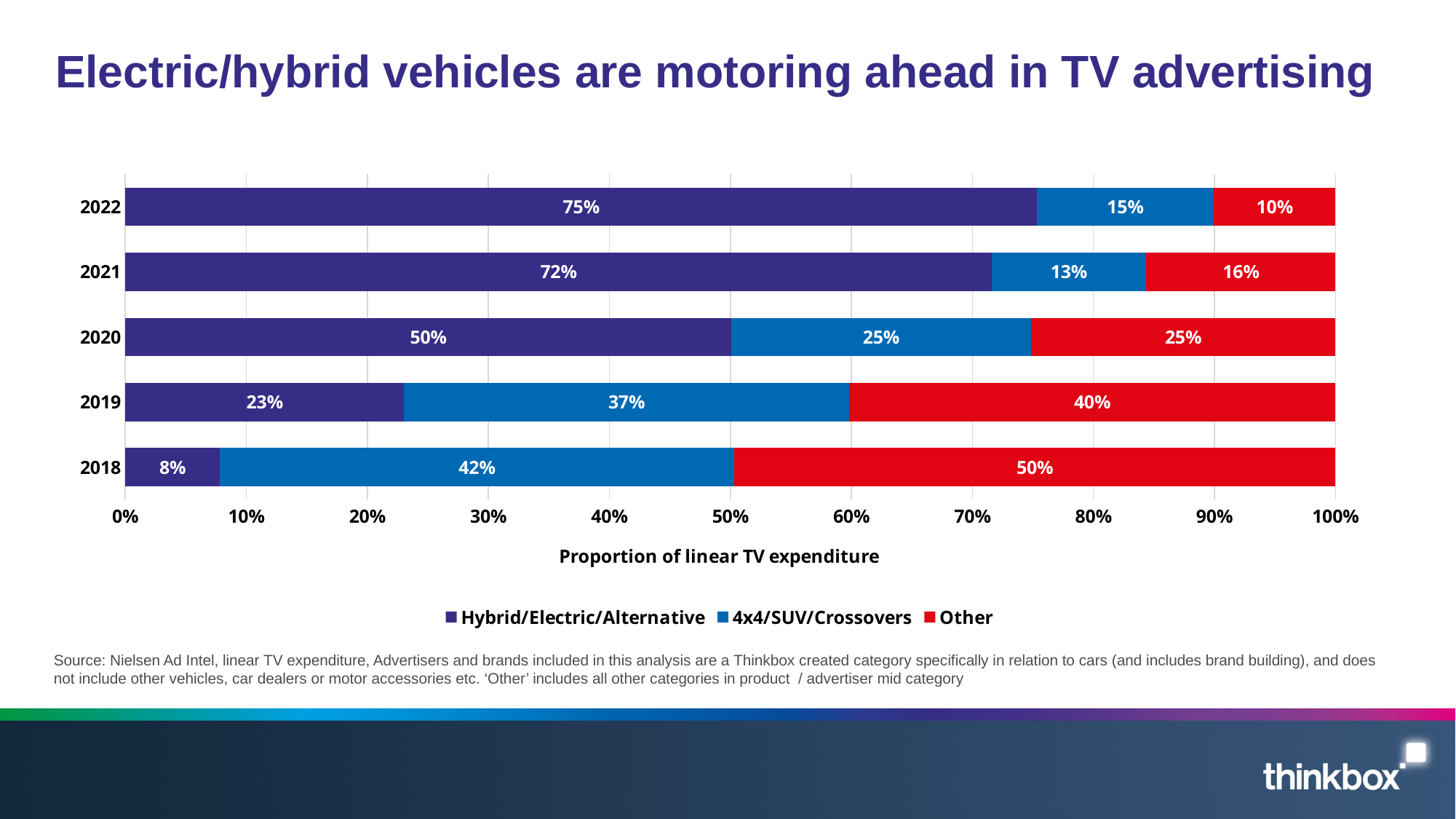
How many years are shown on the chart? 5 Which is larger in 2019: the 4x4/SUV/Crossovers share or the Other share? Other Does the Other share rise or fall from 2018 to 2022? Fall What kind of chart is shown on the slide? Stacked bar chart How many series does the legend list? 3 What is the Hybrid/Electric/Alternative share of linear TV expenditure in 2022? 75% What is the x-axis title of the chart? Proportion of linear TV expenditure What is the difference between the Hybrid/Electric/Alternative share in 2022 and in 2018? 67 percentage points In which year is the Hybrid/Electric/Alternative share highest? 2022 What is the Other share in 2020? 25% What is the 4x4/SUV/Crossovers share in 2018? 42% In which year is the Hybrid/Electric/Alternative share lowest? 2018